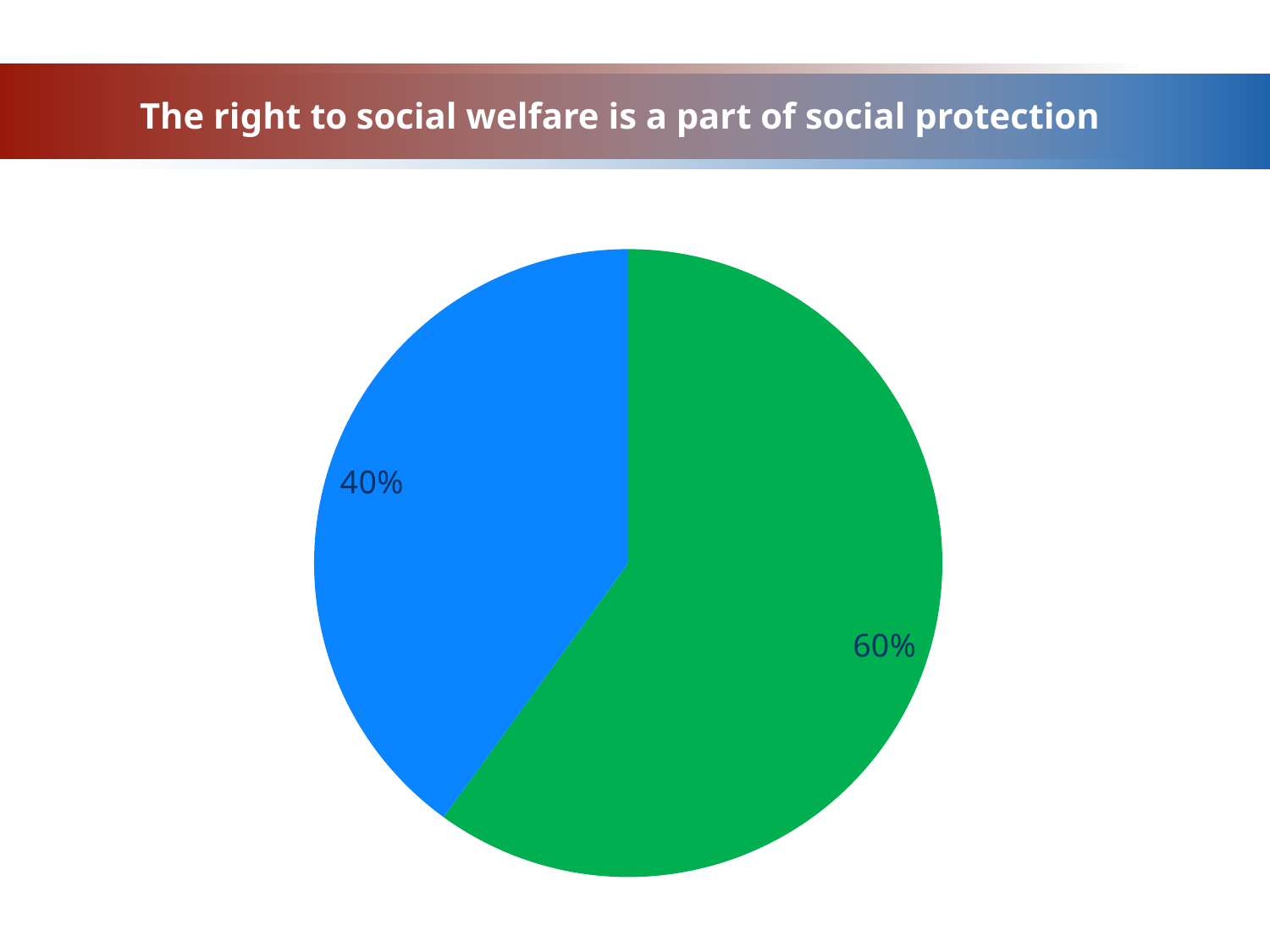
What percentage is shown on the green slice of the pie chart? 60% Which slice of the pie chart is the smallest? the blue slice (40%) What share of the pie does the green slice represent? 60% What two colours are used for the slices of the pie chart? green and blue What share of the pie does the blue slice represent? 40% How many slices does the pie chart have? 2 What percentage is shown on the blue slice of the pie chart? 40% Which is larger, the green slice or the blue slice? the green slice What is the difference in percentage points between the green slice and the blue slice? 20 percentage points Which slice of the pie chart is the largest? the green slice (60%) What is the title shown in the banner above the chart? The right to social welfare is a part of social protection What kind of chart is shown on the slide? pie chart